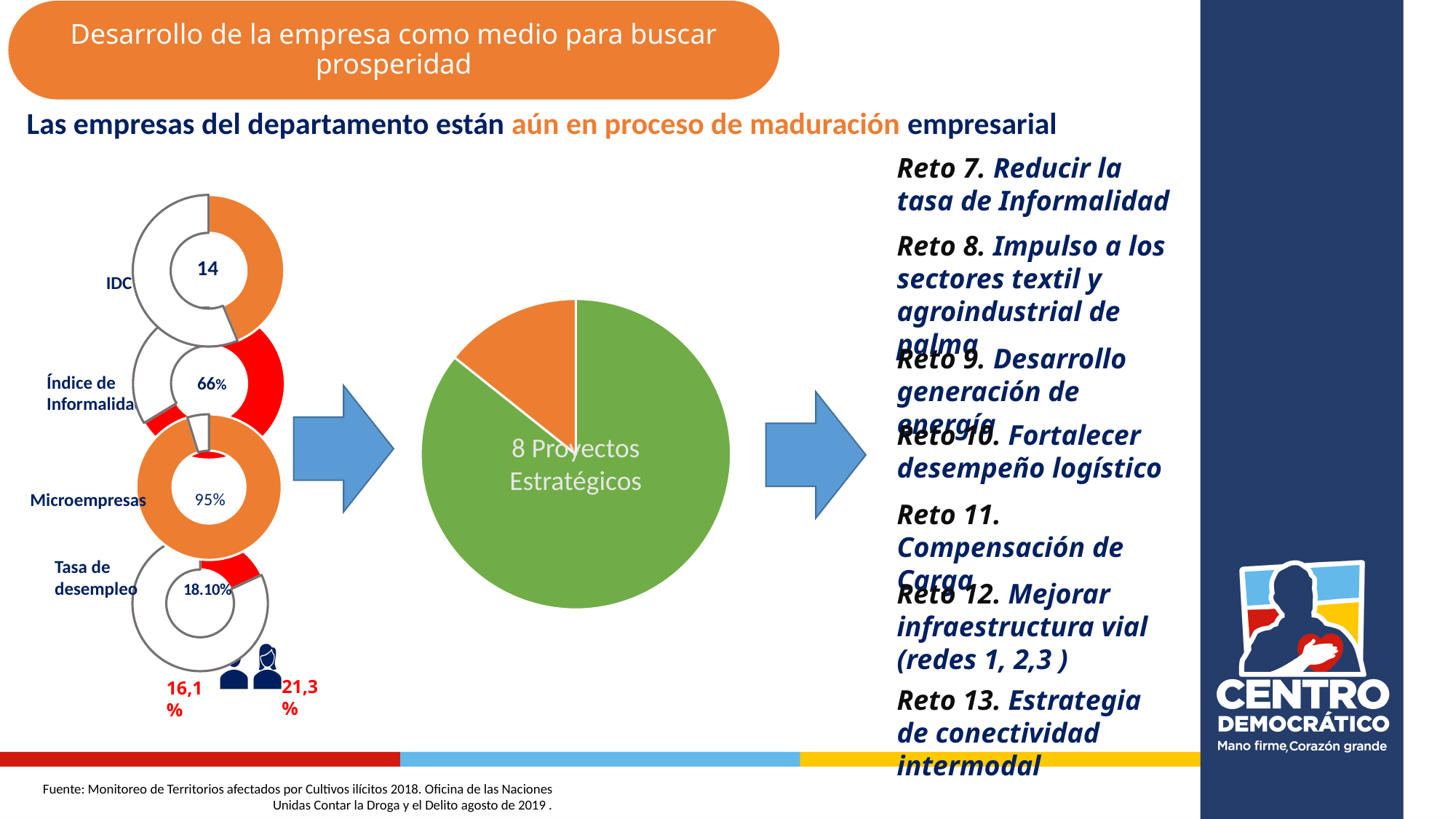
In the pie chart in the centre of the slide, which slice is larger, the green one or the orange one? Green What kind of chart is the large green and orange chart in the centre of the slide? Pie chart What is the difference between the Microempresas value and the Índice de Informalidad value in the donut charts on the left? 29% In the Microempresas donut chart, what value is printed in the centre? 95% In the IDC donut chart on the left, what value is printed in the centre? 14 In the Tasa de desempleo donut chart, what value is printed in the centre? 18.10% What text is written in the centre of the pie chart in the middle of the slide? 8 Proyectos Estratégicos How many donut charts are stacked on the left side of the slide? 4 Among the Índice de Informalidad, Microempresas and Tasa de desempleo donut charts, which shows the lowest percentage? Tasa de desempleo In the Índice de Informalidad donut chart, what value is printed in the centre? 66% How many slices does the pie chart in the centre of the slide have? 2 Among the Índice de Informalidad, Microempresas and Tasa de desempleo donut charts, which shows the highest percentage? Microempresas